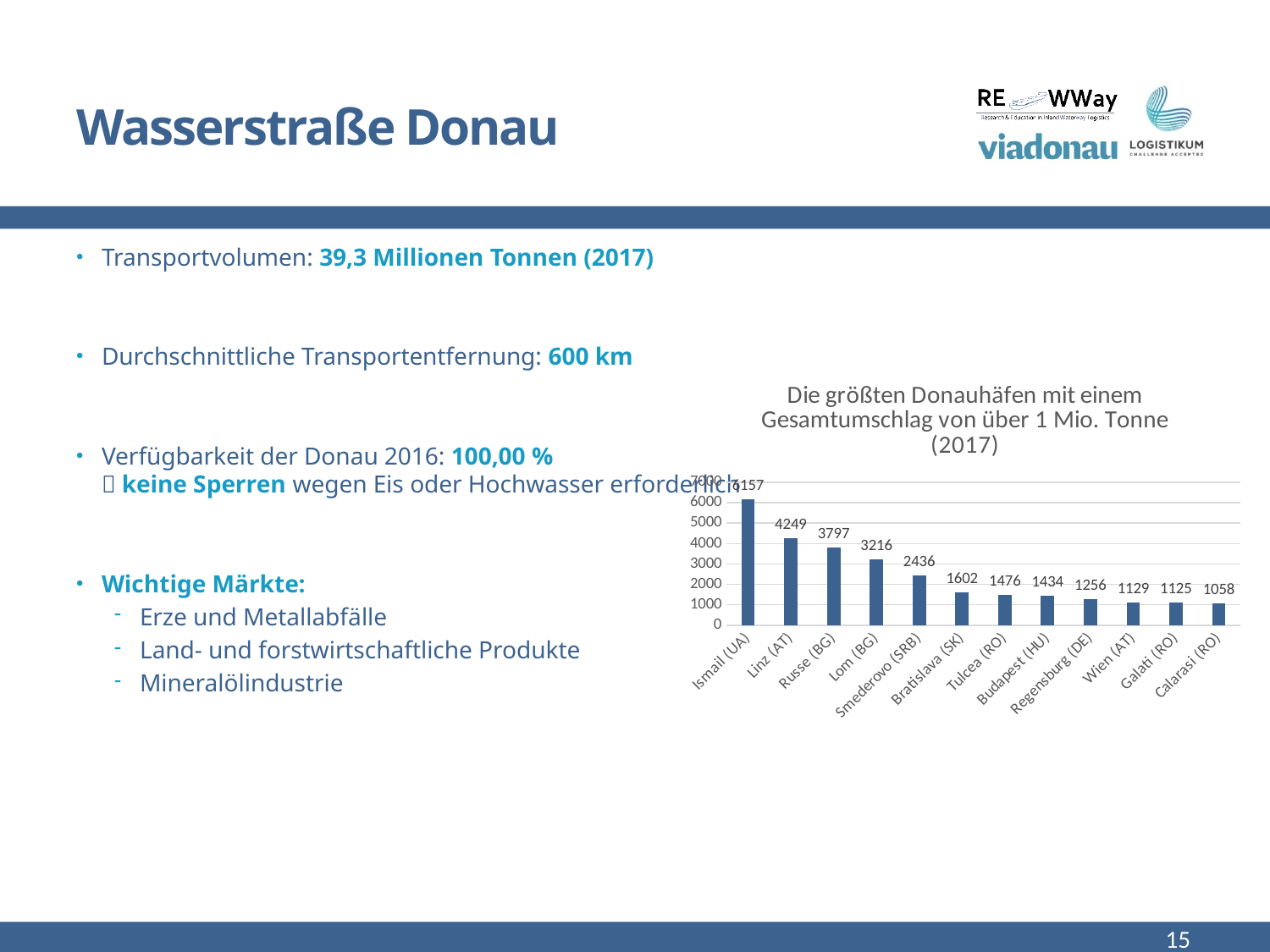
What kind of chart is shown on the slide? bar chart Which port has the highest value in the chart? Ismail (UA) What is the title of the chart? Die größten Donauhäfen mit einem Gesamtumschlag von über 1 Mio. Tonne (2017) Which port has the lowest value in the chart? Calarasi (RO) Which is larger, the value for Bratislava (SK) or the value for Tulcea (RO)? Bratislava (SK) What is the value for Regensburg (DE)? 1256 What is the difference between the values for Russe (BG) and Lom (BG)? 581 How many ports are shown in the chart? 12 Is the value for Budapest (HU) greater or less than 2000? less Do the values rise or fall from left to right along the x axis? fall What is the value for Smederovo (SRB)? 2436 What is the value for Linz (AT)? 4249